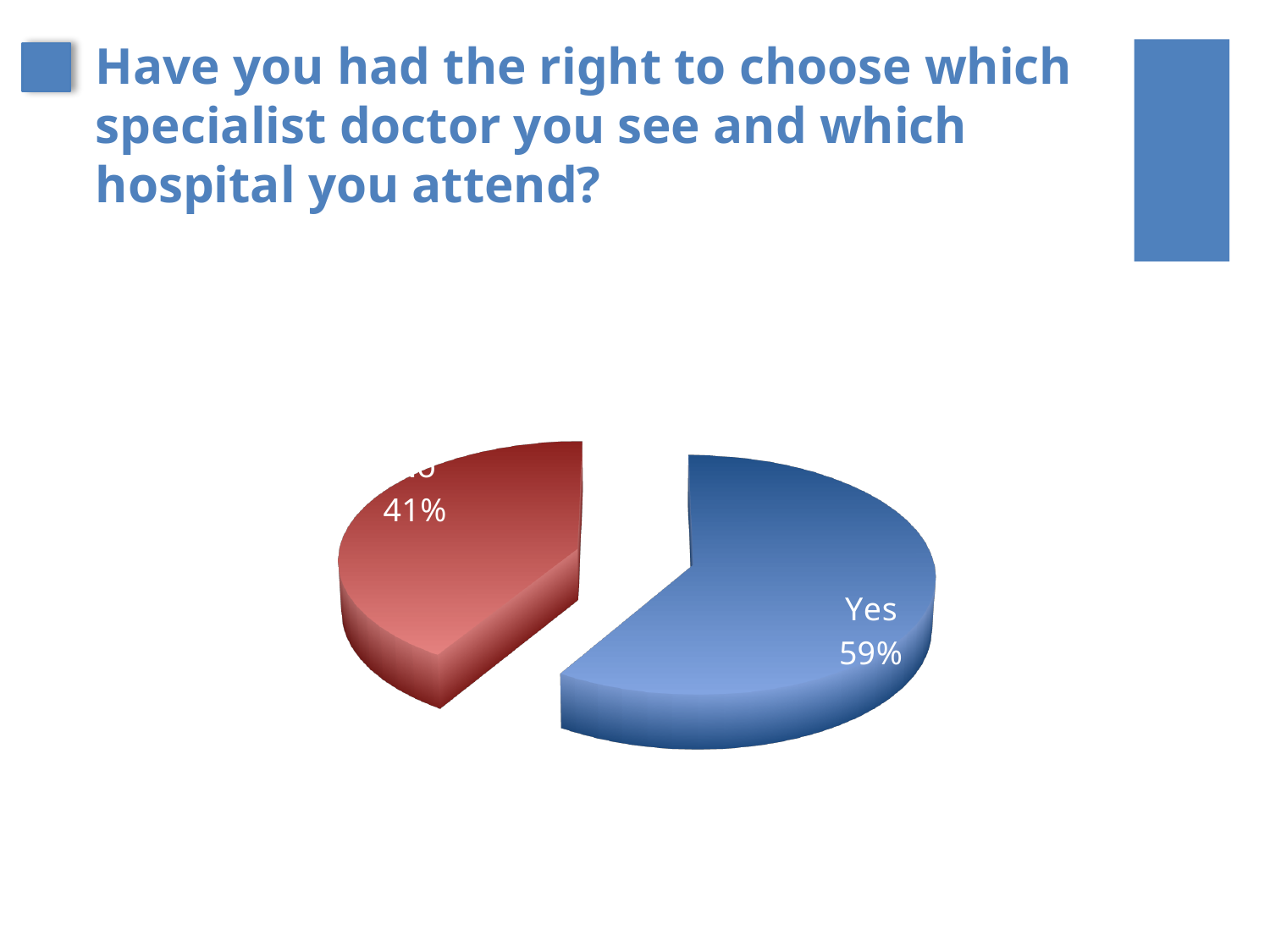
What colour is the Yes slice? blue What question does the slide title ask? Have you had the right to choose which specialist doctor you see and which hospital you attend? How many slices does the pie chart have? 2 What share of the pie does the Yes slice represent? 59% What is the difference in percentage points between the Yes slice and the red slice? 18 Is the Yes slice greater or less than 50%? greater Which slice of the pie is the largest? Yes What kind of chart is shown on the slide? pie chart What percentage is shown on the red slice of the pie? 41% Which is larger, the Yes slice or the red slice? Yes